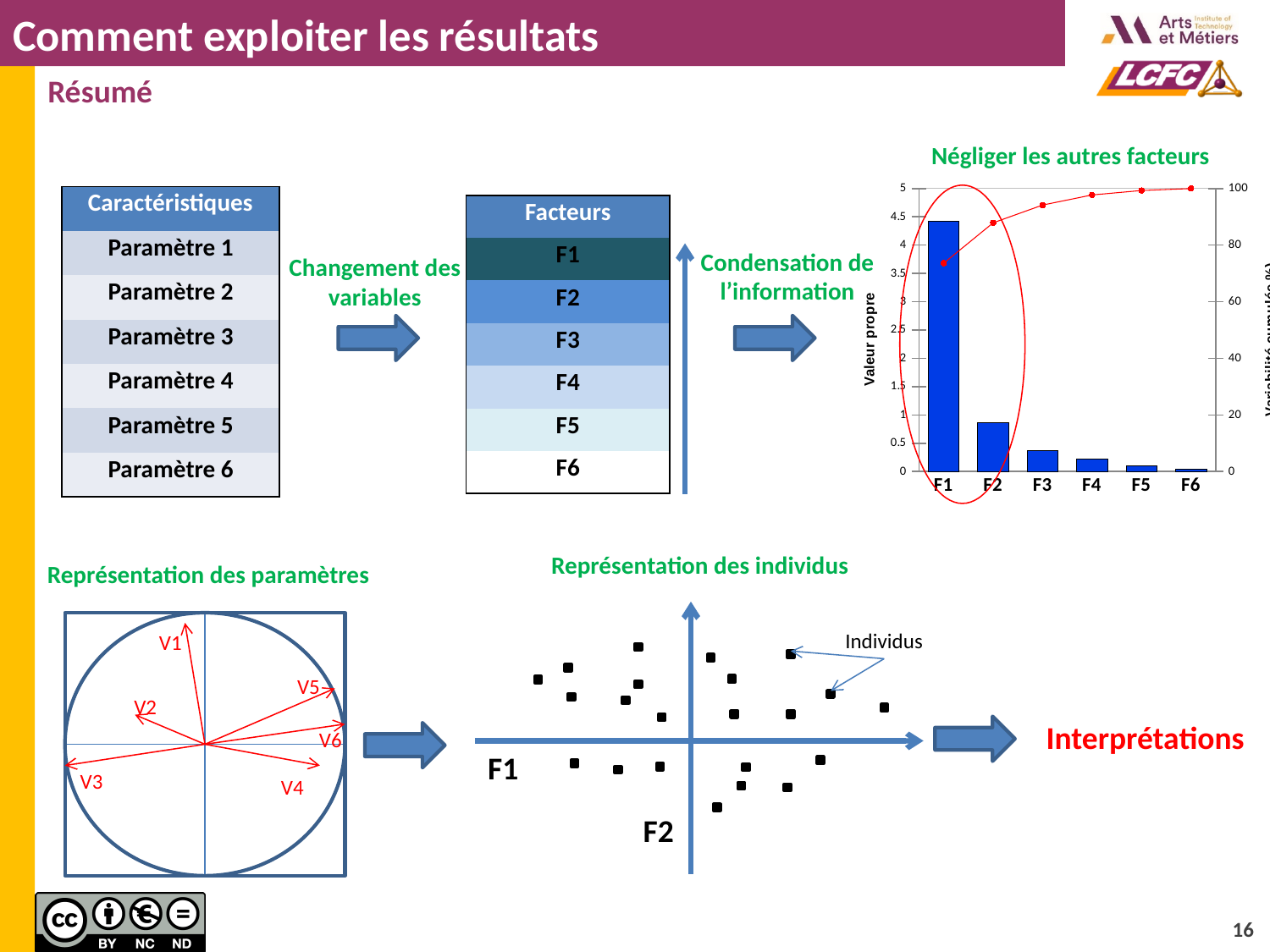
In the chart titled 'Négliger les autres facteurs', what kind of chart is used for the 'Valeur propre' values? bar chart In the chart titled 'Négliger les autres facteurs', which factor has the highest 'Valeur propre'? F1 In the chart titled 'Négliger les autres facteurs', which has the larger 'Valeur propre', F1 or F2? F1 In the chart titled 'Négliger les autres facteurs', how many factors are shown on the x axis? 6 In the chart titled 'Négliger les autres facteurs', what is the title of the left vertical axis? Valeur propre In the chart titled 'Négliger les autres facteurs', do the bar values rise or fall from F1 to F6? fall In the chart titled 'Négliger les autres facteurs', what cumulative value does the red line reach at F6? 100 In the chart titled 'Négliger les autres facteurs', is the 'Valeur propre' for F3 greater or less than 0.5? less In the chart titled 'Négliger les autres facteurs', what colour are the bars? blue In the chart titled 'Négliger les autres facteurs', is the 'Valeur propre' for F1 greater or less than 4? greater In the chart titled 'Négliger les autres facteurs', is the 'Valeur propre' for F2 greater or less than 1? less